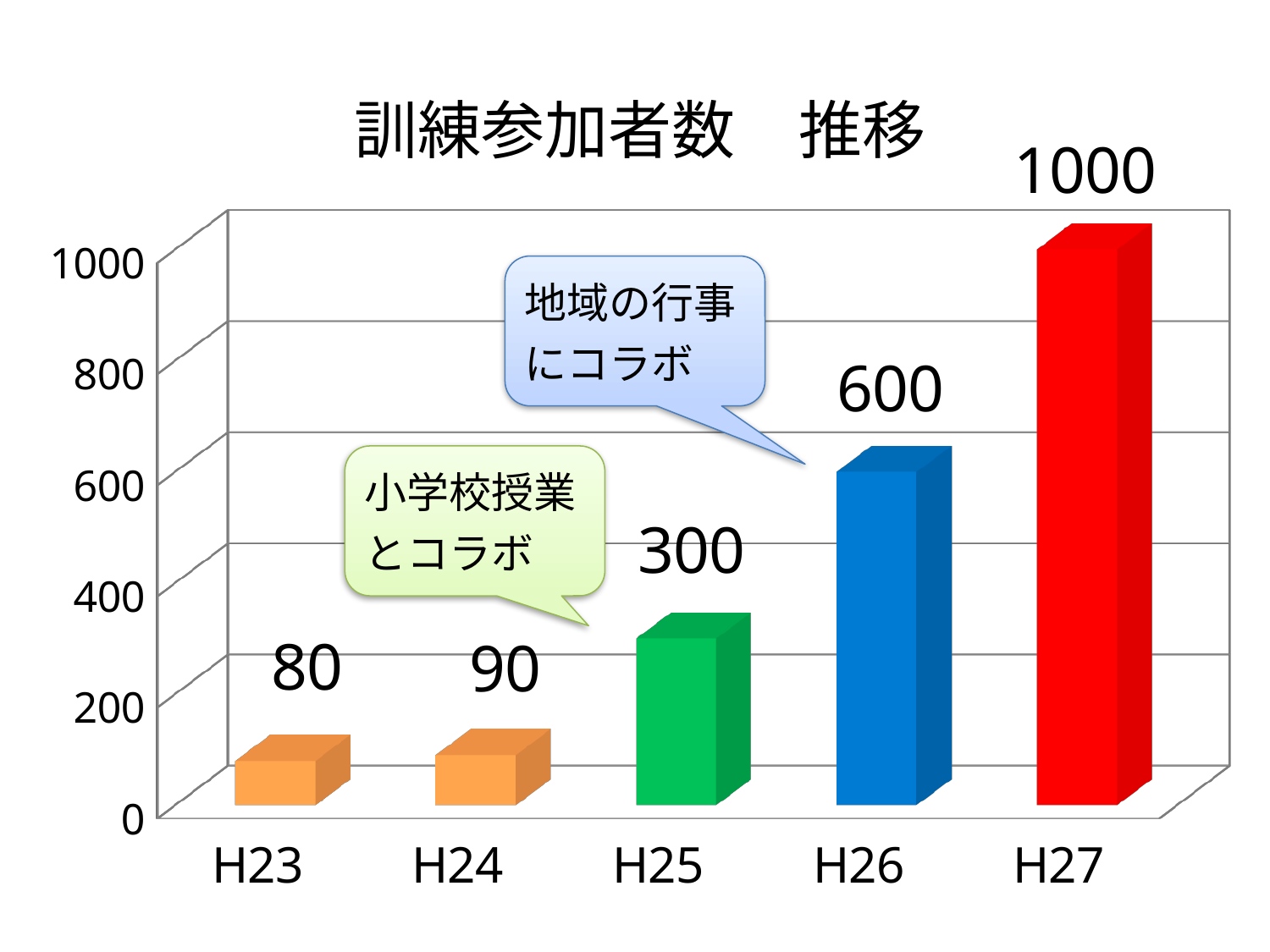
What is the value for H27? 1000 What is the value for H25? 300 What is the difference between the values for H27 and H26? 400 What kind of chart is this? bar chart Which category has the highest value? H27 How many categories are shown on the x axis? 5 What is the value for H23? 80 Do the values rise or fall from H23 to H27? rise What is the difference between the values for H24 and H23? 10 Which category has the lowest value? H23 Which is larger, the value for H25 or the value for H26? H26 What is the title of the chart? 訓練参加者数 推移